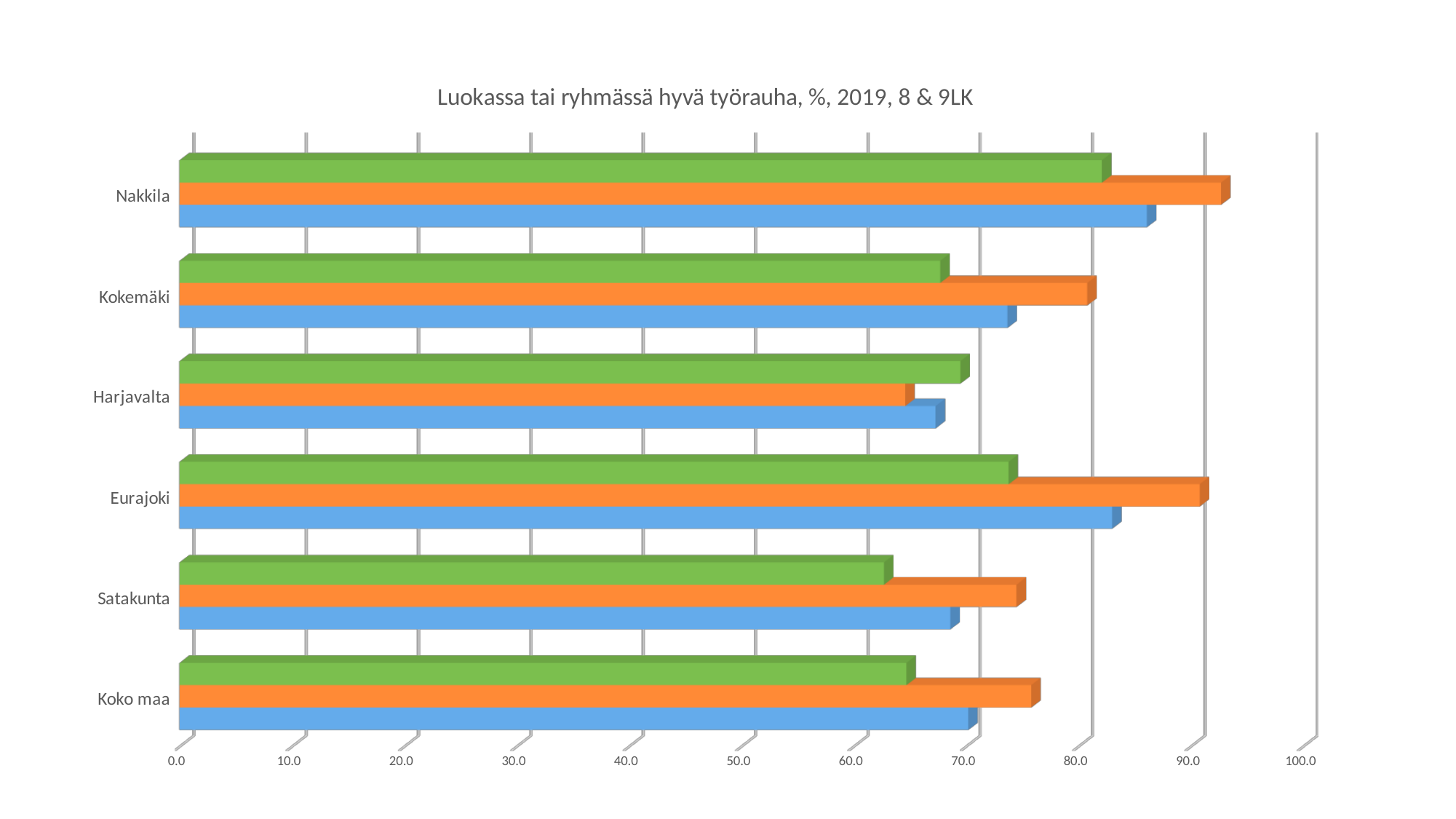
What kind of chart is shown on the slide? bar chart Is the value of the blue bar for Eurajoki greater or less than 80? greater Which is larger, the green bar for Eurajoki or the green bar for Satakunta? Eurajoki How many bars are shown for each category in the chart? 3 Is the value of the green bar for Kokemäki greater or less than 70? less How many categories are shown on the vertical axis of the chart? 6 Is the value of the orange bar for Harjavalta greater or less than 70? less What is the title of the chart? Luokassa tai ryhmässä hyvä työrauha, %, 2019, 8 & 9LK Which category has the highest green bar? Nakkila Which category has the lowest orange bar? Harjavalta